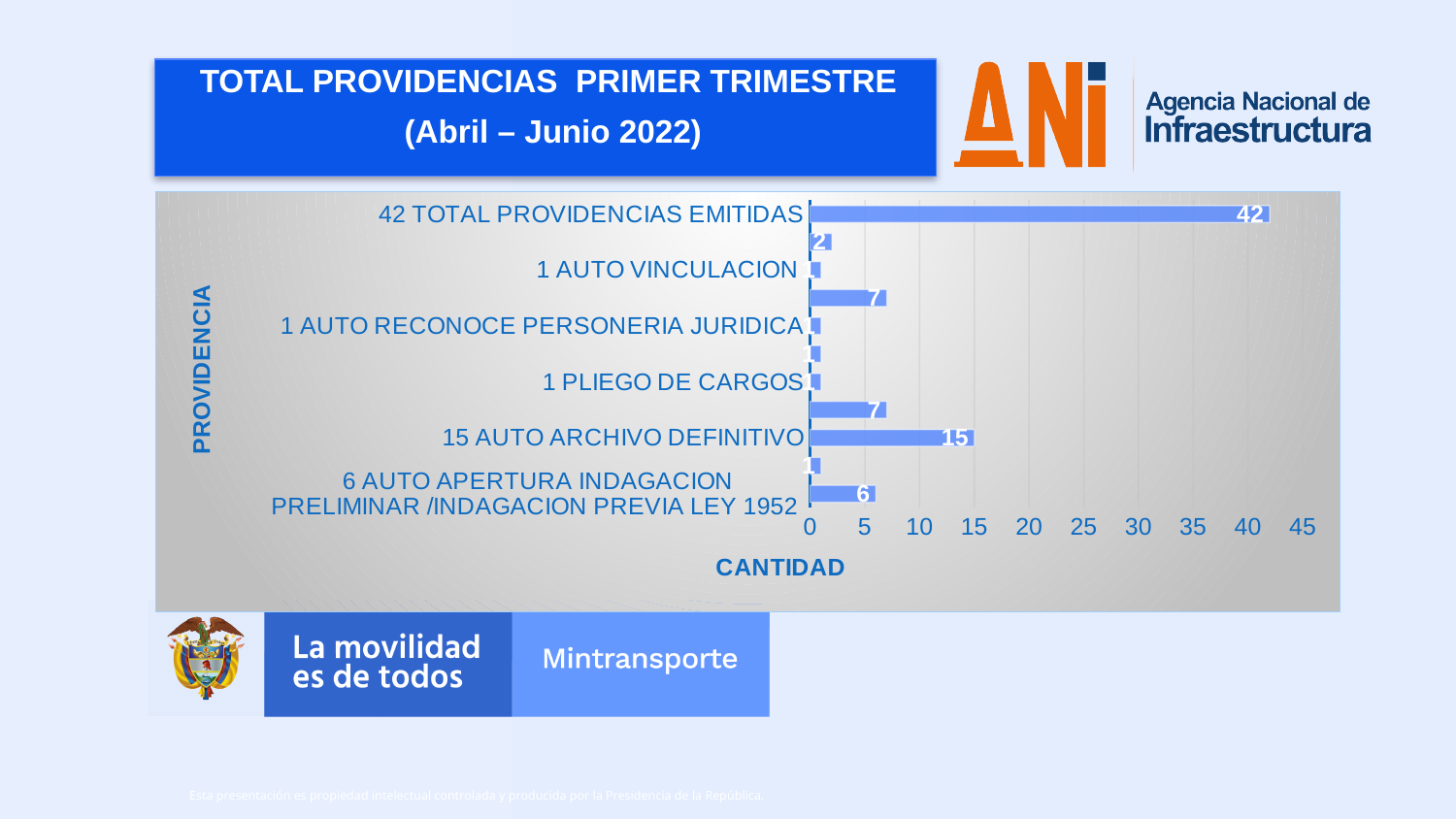
What is the title of the horizontal axis? CANTIDAD Which category has the highest value? 42 TOTAL PROVIDENCIAS EMITIDAS What is the difference between the value for AUTO ARCHIVO DEFINITIVO and the value for AUTO APERTURA INDAGACION PRELIMINAR /INDAGACION PREVIA LEY 1952? 9 Which is larger, the value for AUTO ARCHIVO DEFINITIVO or the value for AUTO APERTURA INDAGACION PRELIMINAR /INDAGACION PREVIA LEY 1952? AUTO ARCHIVO DEFINITIVO What is the value for TOTAL PROVIDENCIAS EMITIDAS? 42 Is the value for TOTAL PROVIDENCIAS EMITIDAS greater or less than 40? greater What is the value for AUTO APERTURA INDAGACION PRELIMINAR /INDAGACION PREVIA LEY 1952? 6 What is the difference between the value for TOTAL PROVIDENCIAS EMITIDAS and the value for AUTO ARCHIVO DEFINITIVO? 27 What is the title of the vertical axis? PROVIDENCIA What type of chart is shown on the slide? bar chart Is the value for AUTO VINCULACION greater or less than 5? less What is the value for AUTO ARCHIVO DEFINITIVO? 15